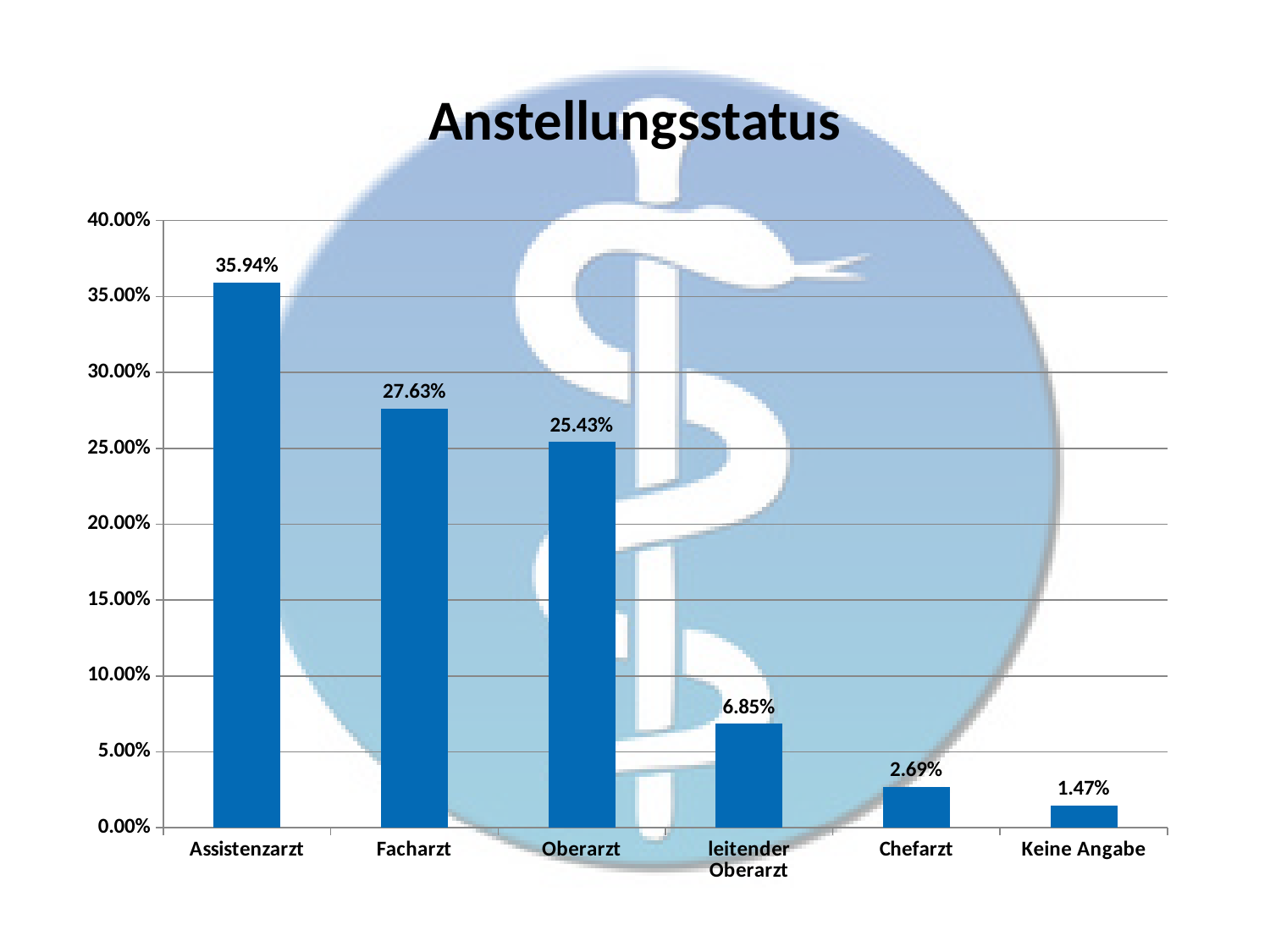
Which category has the highest value? Assistenzarzt What is the value for leitender Oberarzt? 6.85% What kind of chart is shown on the slide? bar chart What is the value for Keine Angabe? 1.47% What is the value for Assistenzarzt? 35.94% Which is larger, the value for Chefarzt or the value for leitender Oberarzt? leitender Oberarzt Which category has the lowest value? Keine Angabe What is the title of the chart? Anstellungsstatus What is the value for Facharzt? 27.63% Is the value for Oberarzt greater or less than 20.00%? greater How many categories are shown on the x axis? 6 What is the difference between the values for Facharzt and Oberarzt? 2.20%